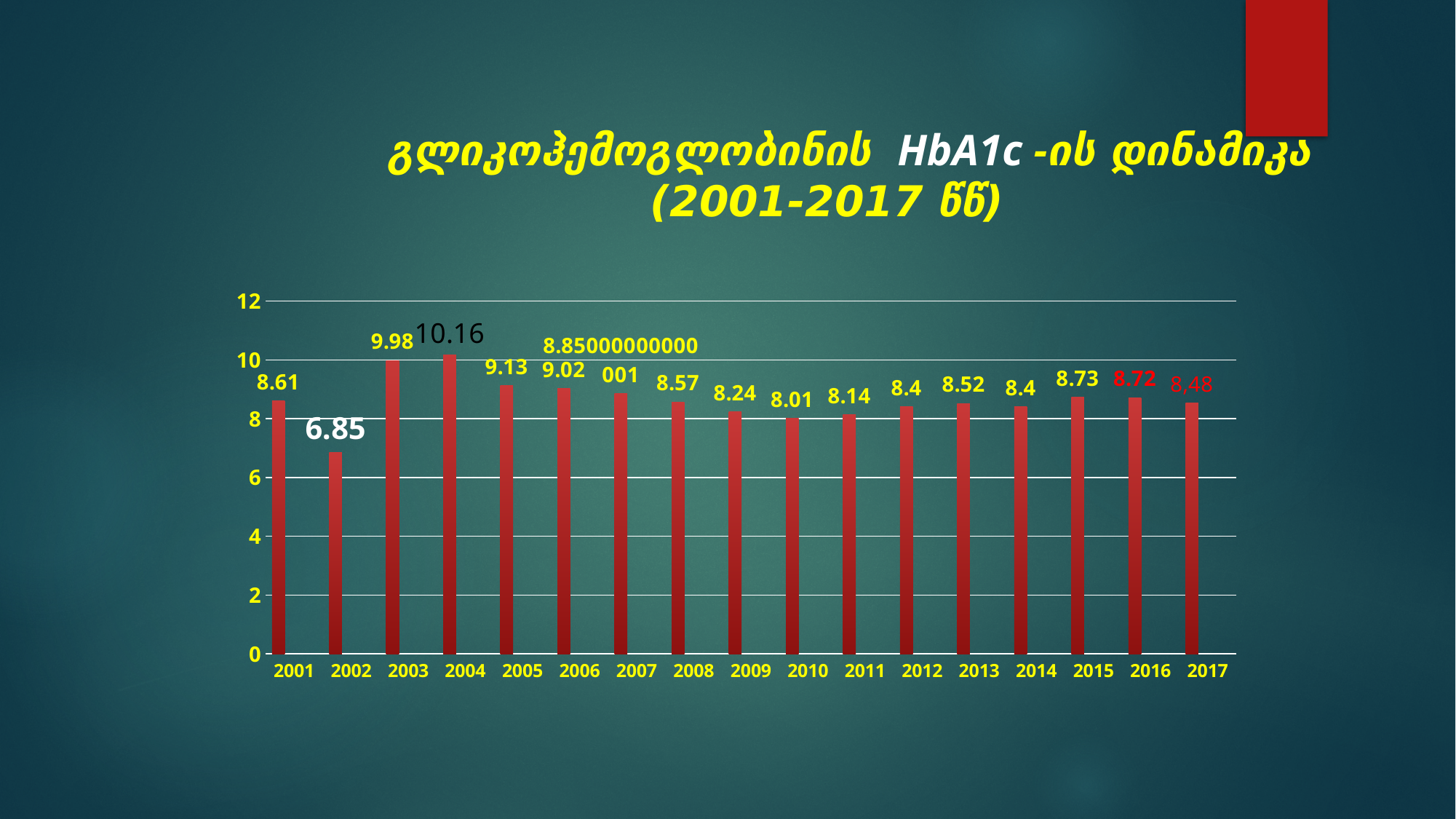
What is the HbA1c value for 2010? 8.01 Which year has the lowest HbA1c value? 2002 How many years (bars) are plotted in the chart? 17 What is the HbA1c value for 2001? 8.61 Is the value for 2002 greater or less than 8? less What is the difference between the HbA1c values for 2004 and 2002? 3.31 What is the HbA1c value for 2017? 8,48 What years does the chart title say the data covers? 2001-2017 What type of chart is shown on the slide? bar chart Which year has the larger HbA1c value, 2003 or 2005? 2003 Which year has the highest HbA1c value? 2004 What is the HbA1c value for 2015? 8.73